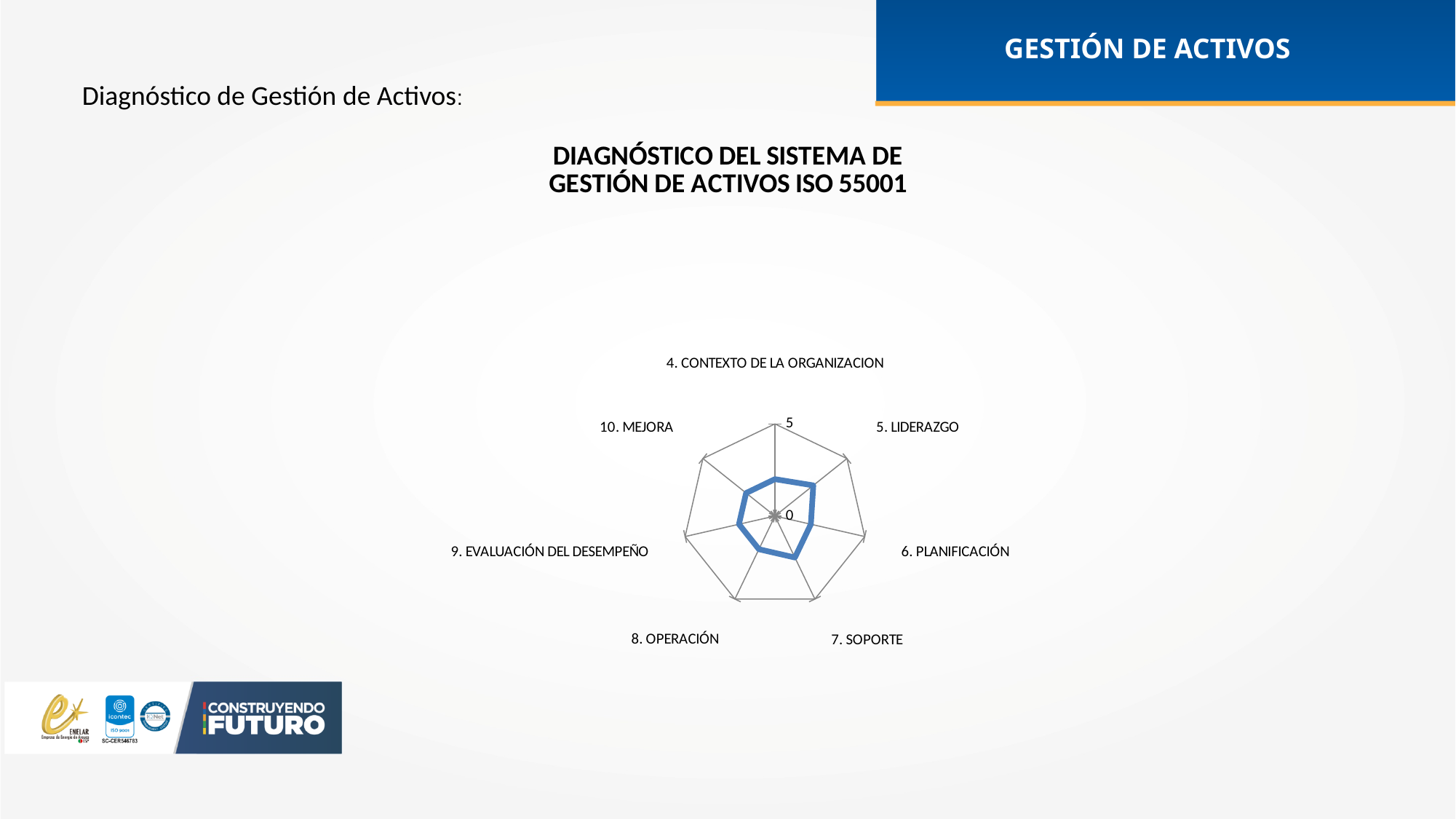
Is the value for 7. SOPORTE greater or less than 5? less What kind of chart is shown on the slide? Radar chart What is the maximum value shown on the radar chart's axis scale? 5 What is the title of the chart? DIAGNÓSTICO DEL SISTEMA DE GESTIÓN DE ACTIVOS ISO 55001 How many categories (axes) does the radar chart have? 7 Which has the larger value, 5. LIDERAZGO or 4. CONTEXTO DE LA ORGANIZACION? 5. LIDERAZGO Which has the larger value, 7. SOPORTE or 9. EVALUACIÓN DEL DESEMPEÑO? 7. SOPORTE Which category label appears at the top of the radar chart? 4. CONTEXTO DE LA ORGANIZACION Is the value for 5. LIDERAZGO greater or less than 5? less